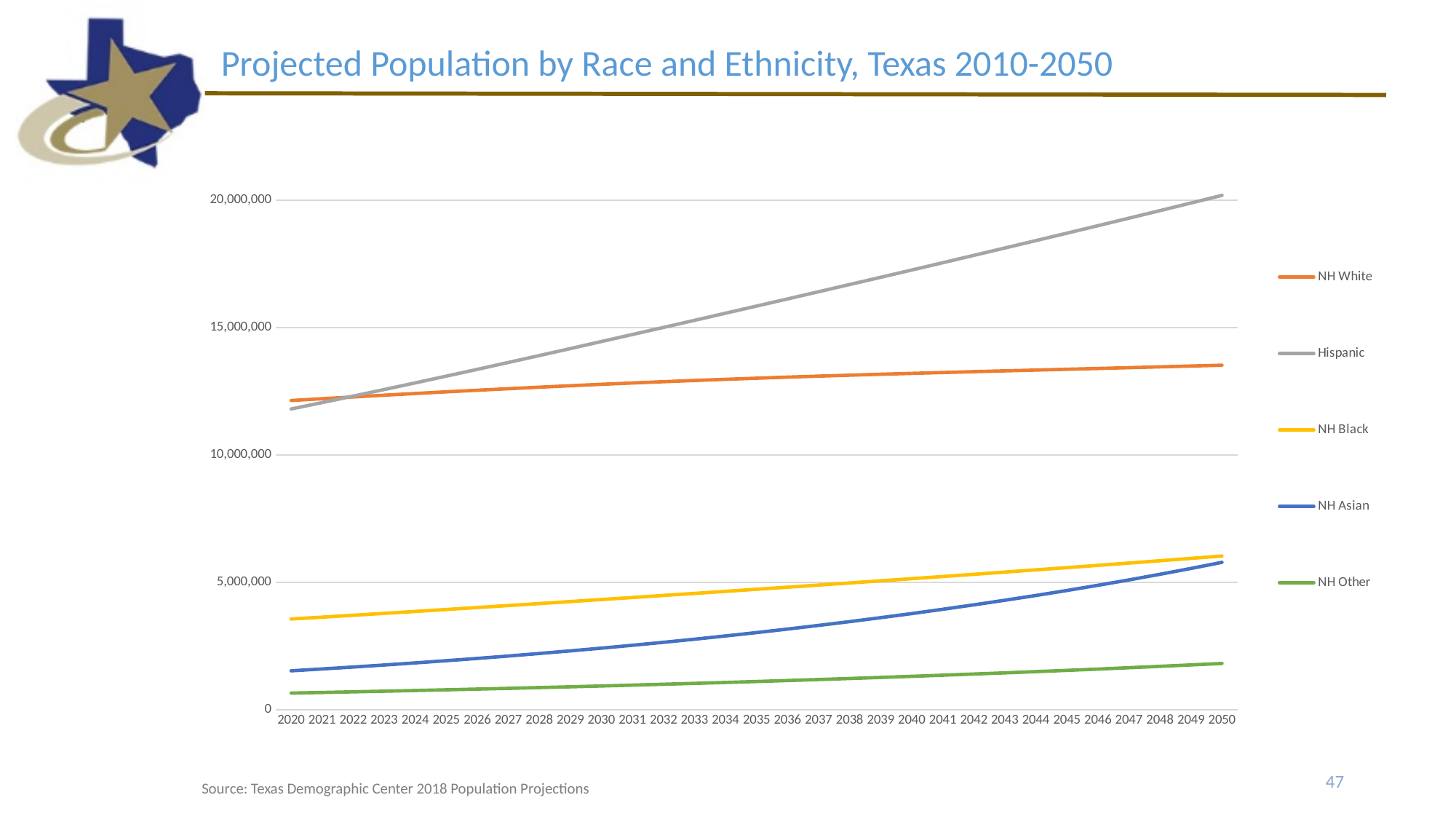
Is the value for NH Asian in 2050 greater or less than 5,000,000? greater Does the Hispanic line rise or fall from 2020 to 2050? rise Which series has the highest value in 2050? Hispanic What is the title of the chart? Projected Population by Race and Ethnicity, Texas 2010-2050 Is the value for NH Black in 2020 greater or less than 5,000,000? less How many series does the legend list? 5 How many years are shown along the x axis? 31 In 2020, which is larger: NH Black or NH Asian? NH Black Which series has the lowest value in 2050? NH Other Is the value for NH White in 2050 greater or less than 15,000,000? less What kind of chart is shown on the slide? line chart Which series has the highest value in 2020? NH White